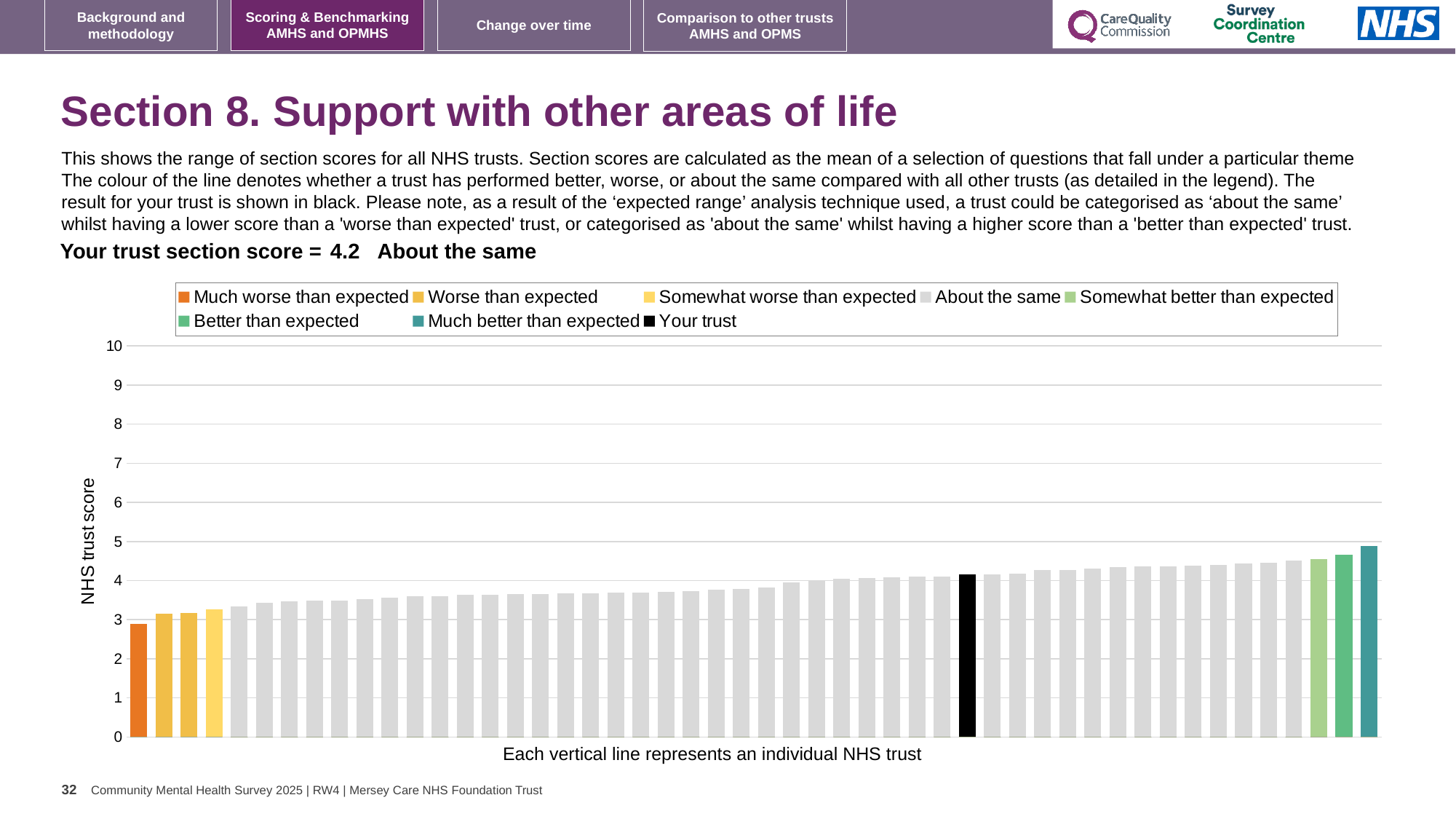
Do the bar values rise or fall from left to right along the x axis? rise Is the value of the rightmost bar greater or less than 4? greater What colour is used for the bar representing your trust? black How many entries does the chart legend list? 8 Is the value for your trust (the black bar) greater or less than 4? greater What kind of chart is shown on the slide? bar chart Which legend category does the lowest bar belong to? Much worse than expected Which legend category does the highest bar belong to? Much better than expected What is the section score for your trust shown on the slide? 4.2 What is the label on the vertical axis of the chart? NHS trust score Which category is your trust placed in for this section? About the same Is the value of the leftmost (orange) bar greater or less than 4? less